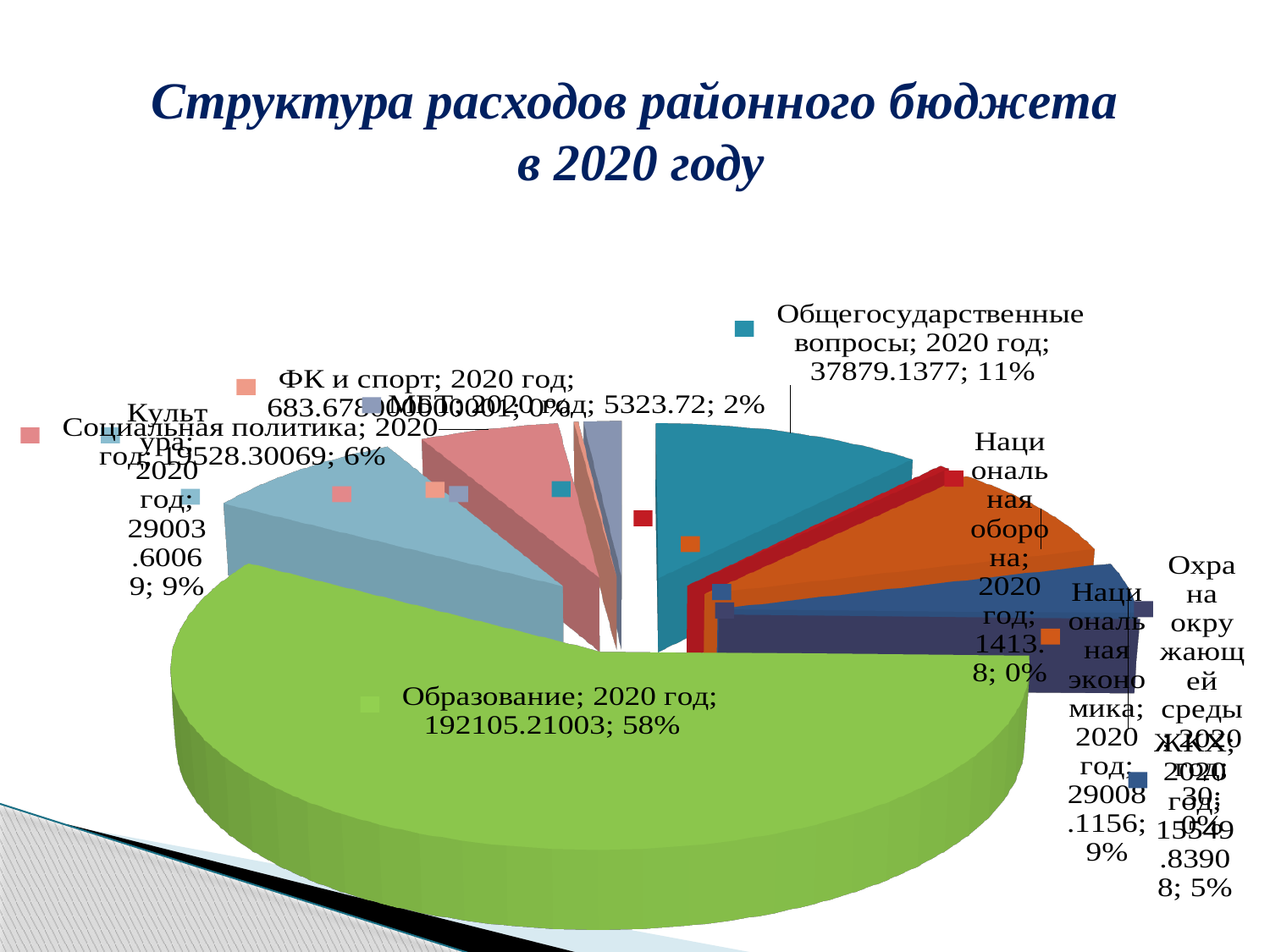
What is the value shown for МБТ in 2020? 5323.72 What is the title of the chart on the slide? Структура расходов районного бюджета в 2020 году Which is larger: the value for Общегосударственные вопросы or the value for Социальная политика? Общегосударственные вопросы By how many percentage points does the share of Образование exceed the share of Общегосударственные вопросы? 47 percentage points What share of the 2020 district budget expenditure goes to Образование? 58% What is the value shown for Общегосударственные вопросы in 2020? 37879.1377 What is the value shown for Национальная оборона in 2020? 1413.8 Which expenditure category has the largest slice of the pie? Образование What is the value shown for Национальная экономика in 2020? 29008.1156 What percentage share is shown for Социальная политика? 6% What kind of chart is shown on the slide? pie chart What percentage share is shown for ЖКХ? 5%